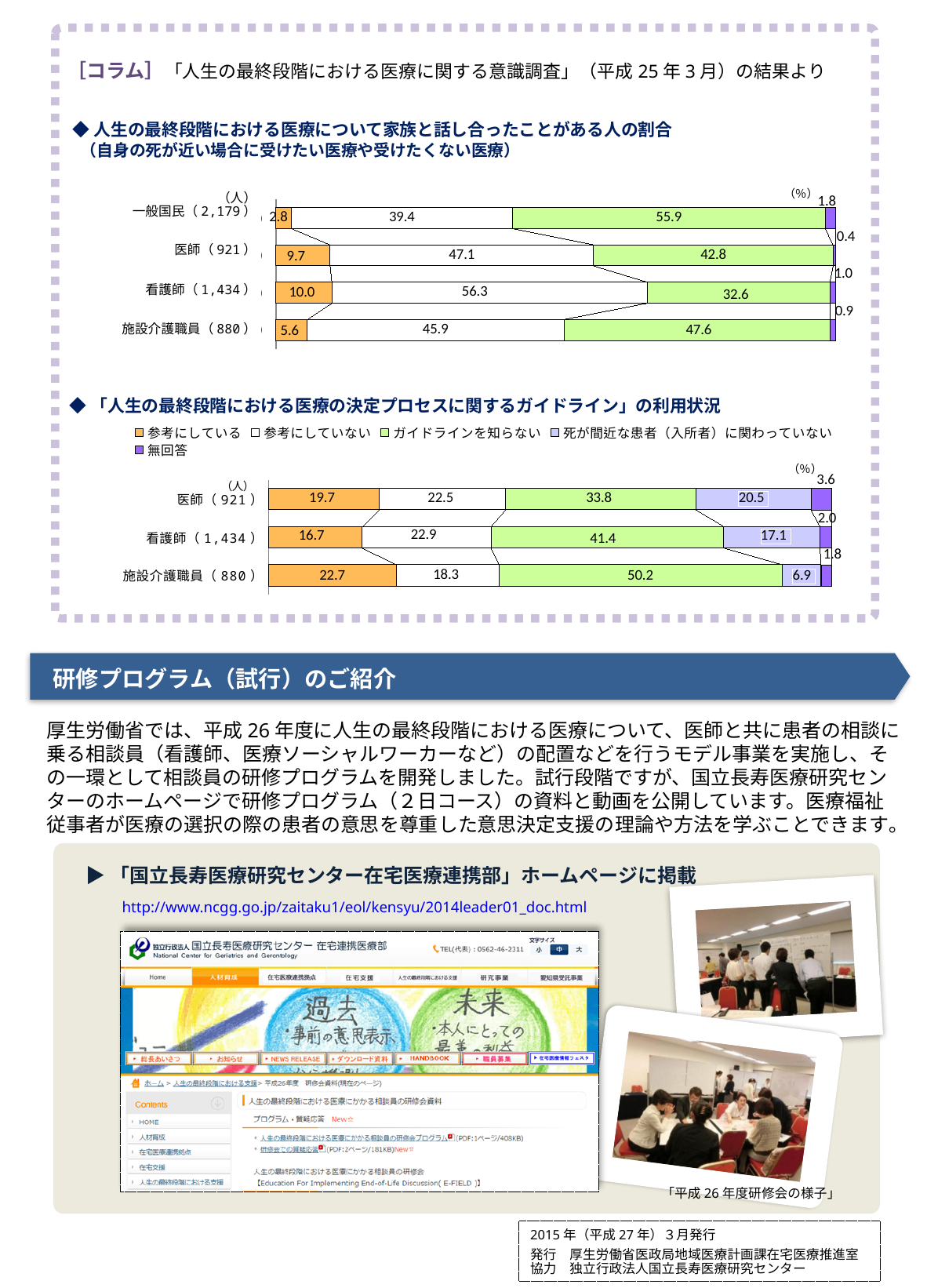
In the first chart (家族と話し合ったことがある人の割合), is the white segment larger for 看護師 or for 医師? 看護師 In the first chart (家族と話し合ったことがある人の割合), what is the value of the green segment for 一般国民? 55.9 In the second chart (ガイドライン利用状況), how many groups are shown? 3 In the second chart (ガイドライン利用状況), what percentage of 施設介護職員 answered ガイドラインを知らない? 50.2 In the second chart (ガイドライン利用状況), which group has the lowest value for 死が間近な患者（入所者）に関わっていない? 施設介護職員 In the second chart (ガイドライン利用状況), how many series does the legend list? 5 In the second chart (ガイドライン利用状況), what percentage of 医師 answered 参考にしている? 19.7 In the second chart (ガイドライン利用状況), what percentage of 看護師 answered 死が間近な患者（入所者）に関わっていない? 17.1 What type of chart is used for the first chart (家族と話し合ったことがある人の割合)? Stacked bar chart In the second chart (ガイドライン利用状況), which group has the highest value for ガイドラインを知らない? 施設介護職員 In the first chart (家族と話し合ったことがある人の割合), which group has the highest value in the orange (first) segment? 看護師 In the second chart (ガイドライン利用状況), what is the difference between the 参考にしている values for 施設介護職員 and 看護師? 6.0